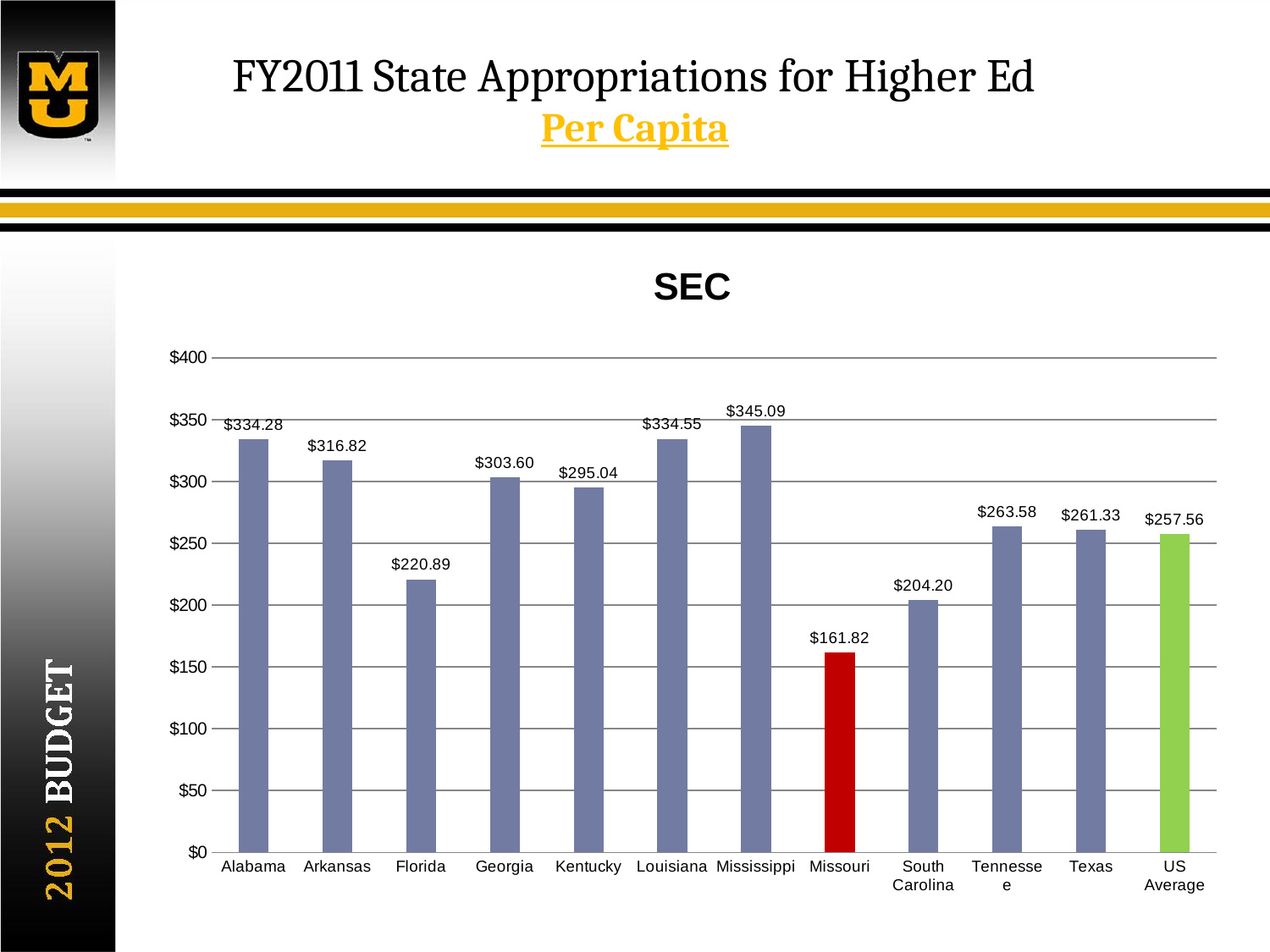
Which category has the highest value? Mississippi Which is larger, the value for Georgia or the value for Kentucky? Georgia How much lower is Missouri's value than the US Average? $95.74 What is the difference between the values for Mississippi and Missouri? $183.27 What is the per capita value for Missouri? $161.82 What type of chart is shown on the slide? bar chart How many categories are shown on the x axis? 12 What is the title of the chart? SEC What is the per capita value for Florida? $220.89 What is the value shown for the US Average? $257.56 What is the per capita value for Mississippi? $345.09 Which category has the lowest value? Missouri